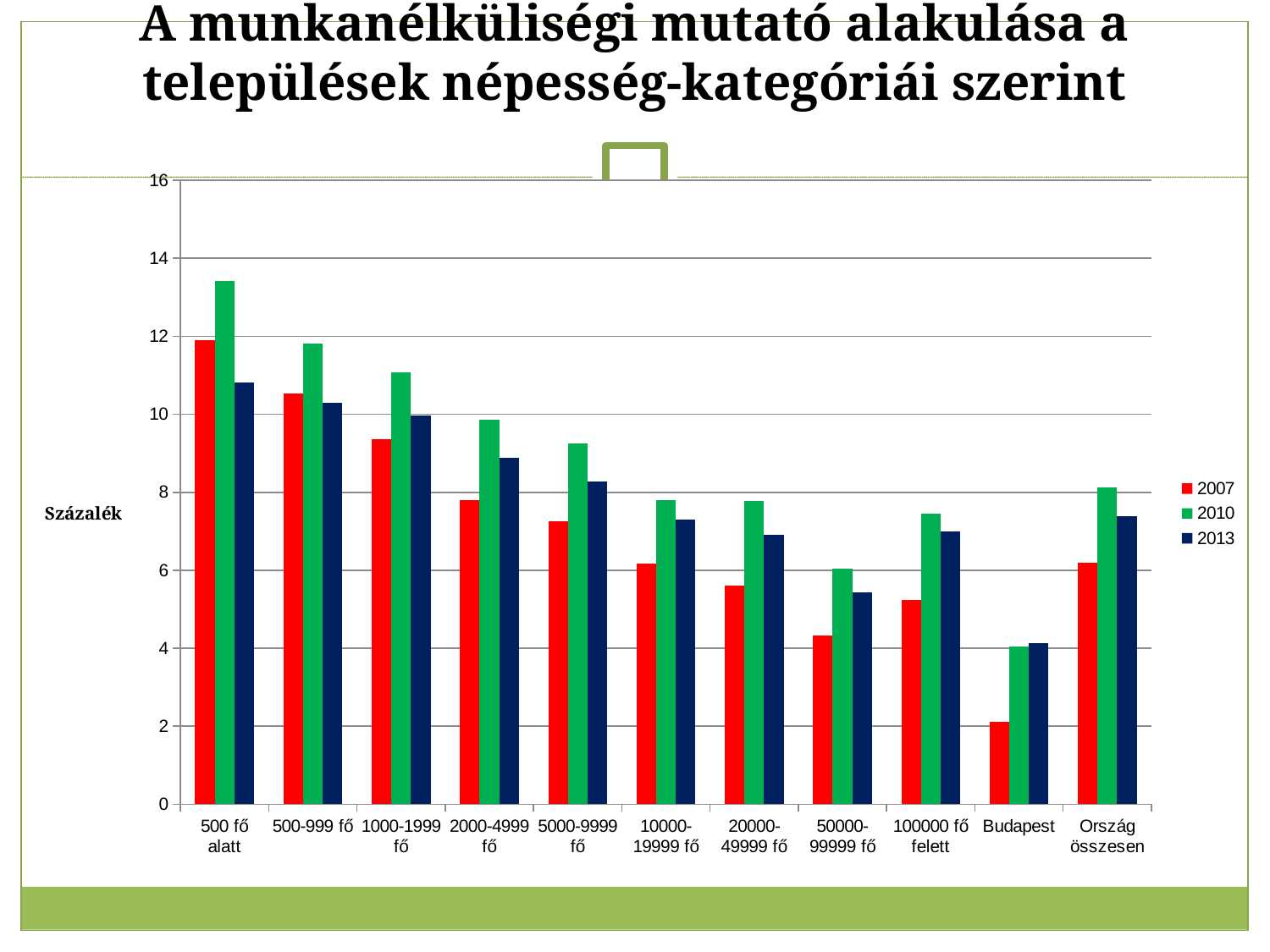
For Ország összesen, which is larger: the 2007 value or the 2010 value? 2010 What kind of chart is shown on the slide? bar chart Which category has the highest value for the 2010 series? 500 fő alatt Is the 2007 value for Budapest greater or less than 4? less Do the 2007 values rise or fall from 500 fő alatt to 100000 fő felett? fall Is the 2013 value for Ország összesen greater or less than 8? less What is the label on the vertical axis? Százalék How many categories are shown on the x axis? 11 Is the 2010 value for 500 fő alatt greater or less than 12? greater How many series does the legend list? 3 Which category has the lowest value for the 2007 series? Budapest For 500 fő alatt, which is larger: the 2007 value or the 2013 value? 2007